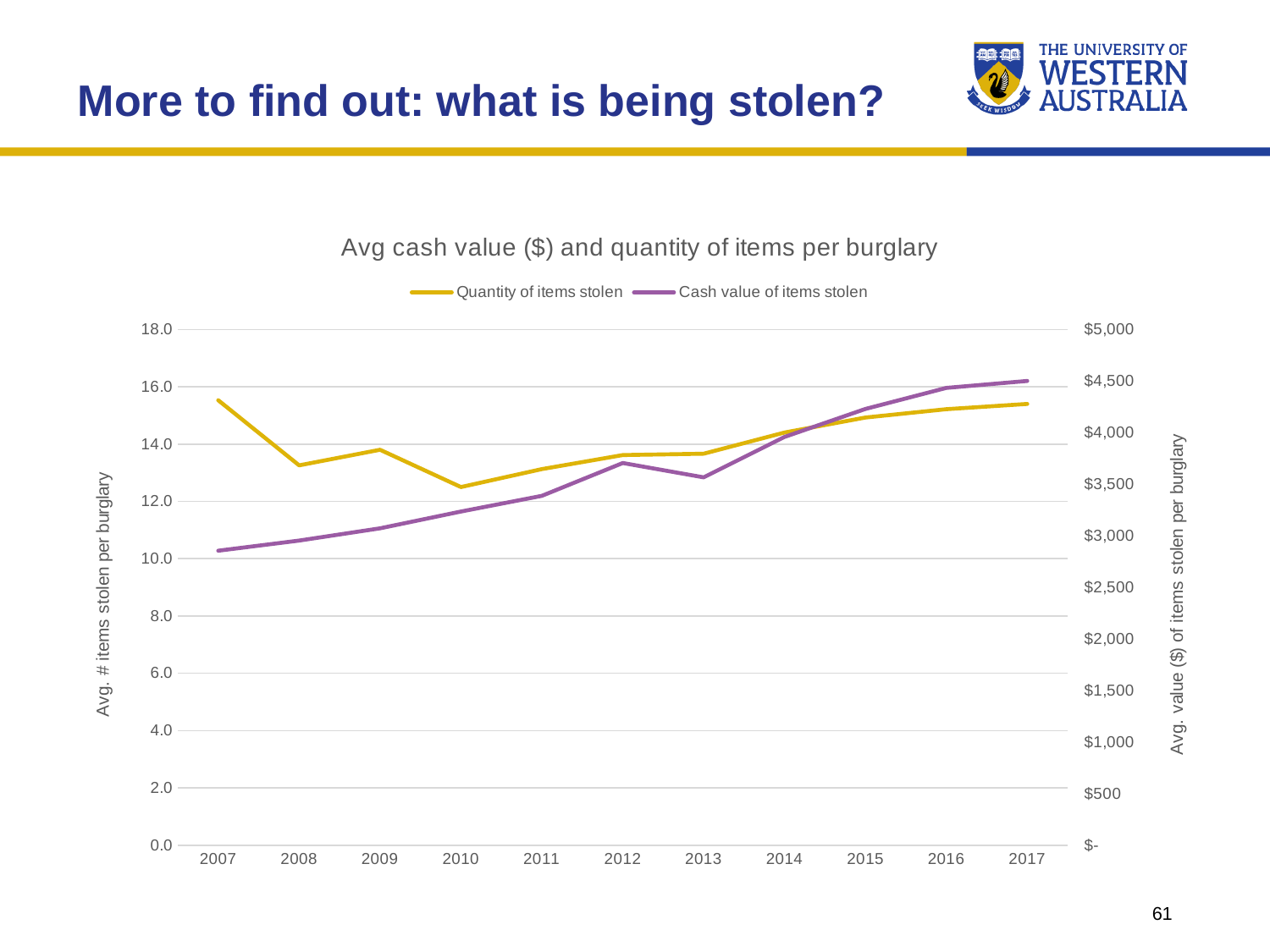
Is the cash value of items stolen in 2007 greater or less than $3,500? less In which year is the quantity of items stolen highest? 2007 What kind of chart is shown on the slide? Line chart Is the cash value of items stolen in 2017 greater or less than $4,000? greater Does the cash value of items stolen generally rise or fall from 2007 to 2017? rise How many series does the legend list? 2 In which year is the quantity of items stolen lowest? 2010 In which year is the cash value of items stolen lowest? 2007 How many years are plotted along the x axis? 11 Is the quantity of items stolen in 2007 greater or less than 14.0? greater What is the title of the chart? Avg cash value ($) and quantity of items per burglary